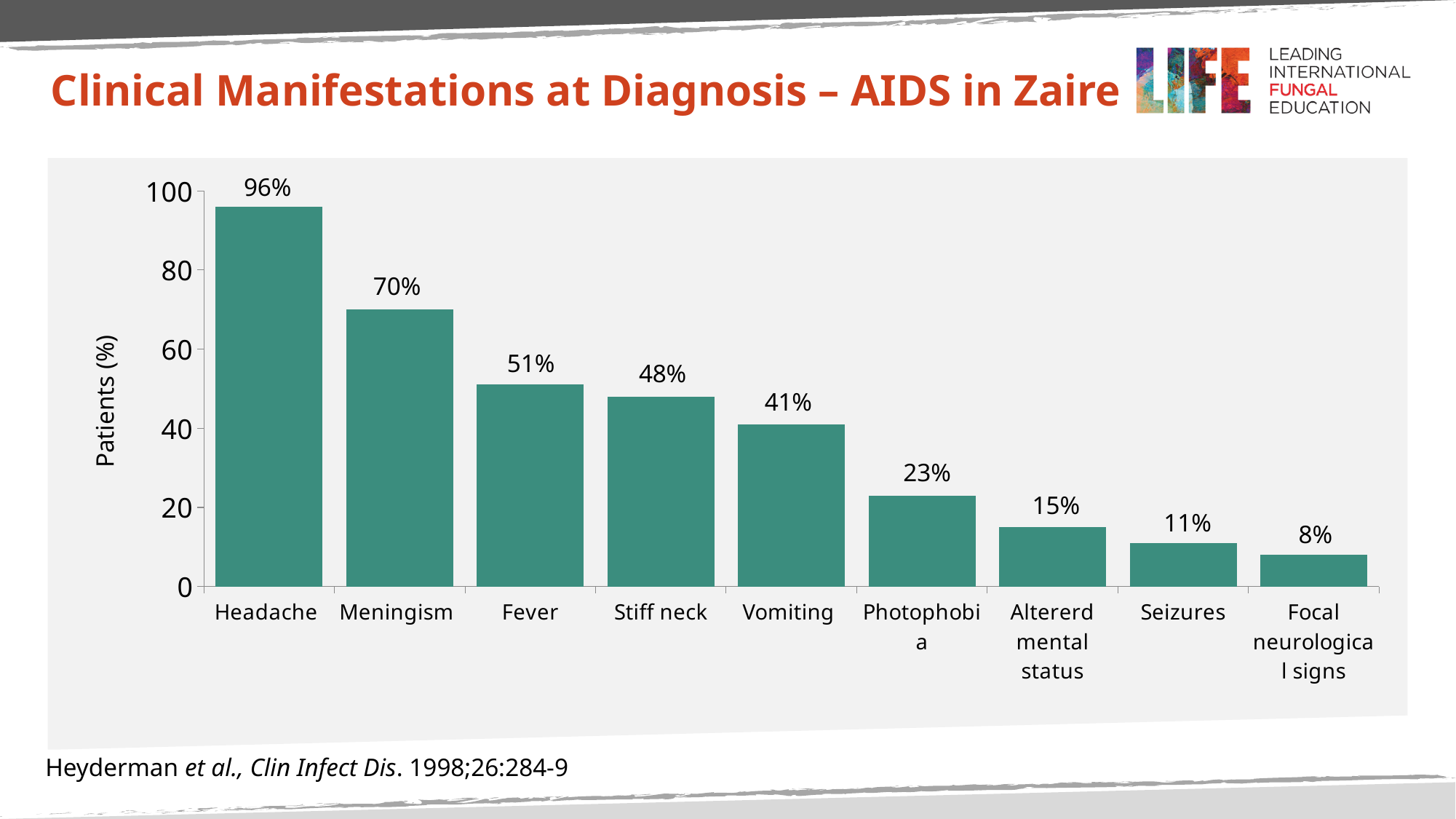
What is the label of the y axis? Patients (%) What is the difference in percentage points between Headache and Meningism? 26 Is the value for Meningism greater or less than 60? greater What is the value shown for Vomiting? 41% What kind of chart is shown on the slide? Bar chart What percentage of patients had altered mental status? 15% Which clinical manifestation has the highest percentage of patients? Headache What percentage of patients had headache at diagnosis? 96% What is the difference in percentage points between Fever and Stiff neck? 3 How many clinical manifestations are shown on the x axis? 9 Which clinical manifestation has the lowest percentage of patients? Focal neurological signs Which is larger, the value for Photophobia or the value for Seizures? Photophobia